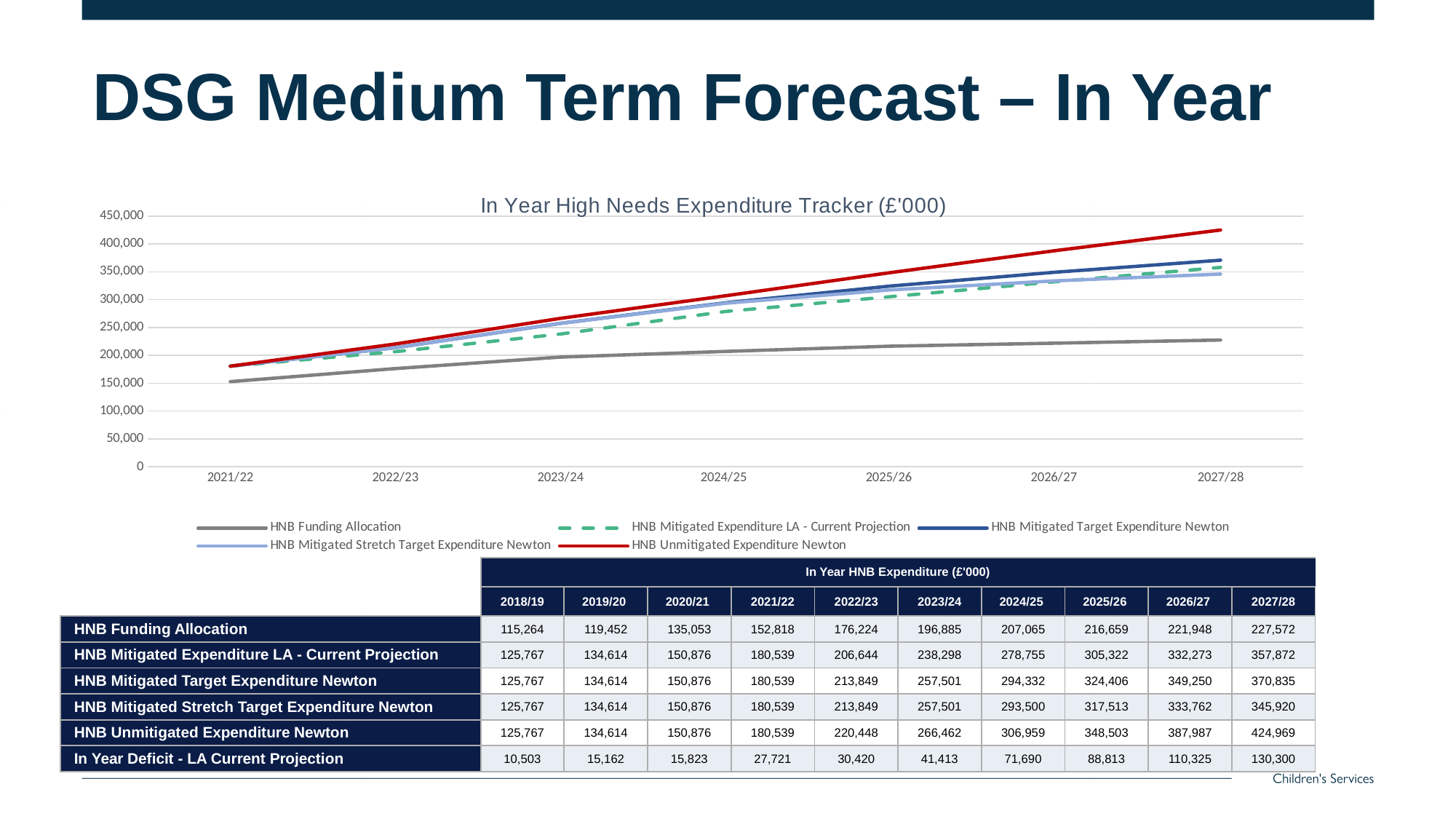
What is the title of the chart? In Year High Needs Expenditure Tracker (£'000) According to the table, what is the HNB Unmitigated Expenditure Newton value for 2027/28? 424,969 Does the HNB Unmitigated Expenditure Newton line rise or fall from 2021/22 to 2027/28? Rise What kind of chart is shown on the slide? Line chart Using the table values, what is the difference between HNB Unmitigated Expenditure Newton and HNB Funding Allocation in 2027/28? 197,397 In 2025/26, which is larger: HNB Mitigated Target Expenditure Newton or HNB Mitigated Expenditure LA - Current Projection? HNB Mitigated Target Expenditure Newton Which series has the highest value in 2027/28? HNB Unmitigated Expenditure Newton How many series does the chart legend list? 5 How many years are plotted along the x axis of the chart? 7 Which series has the lowest value in 2027/28? HNB Funding Allocation According to the table, what is the HNB Funding Allocation value for 2027/28? 227,572 Is the value for HNB Funding Allocation in 2021/22 greater or less than 200,000? less